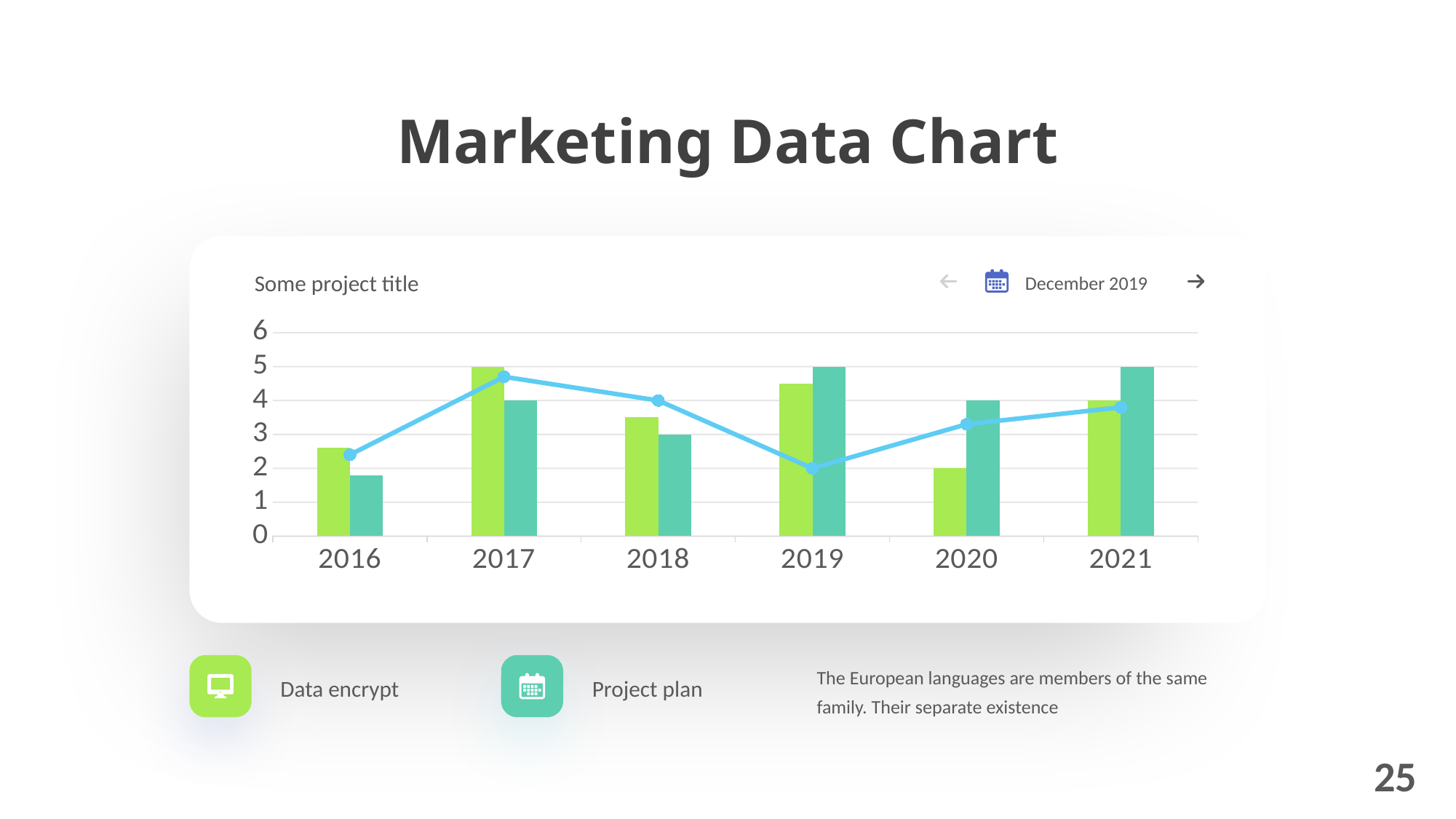
What is the difference between the teal bar for 2021 and the teal bar for 2020? 1 In which year is the light green bar the lowest? 2020 What is the value of the light green bar for 2017? 5 What is the value of the teal bar for 2018? 3 What is the title shown above the chart inside the card? Some project title Which is larger in 2019, the light green bar or the teal bar? the teal bar What is the value of the blue line point for 2019? 2 What is the value of the light green bar for 2020? 2 What is the value of the blue line point for 2018? 4 How many years are shown on the x axis of the chart? 6 In which year is the teal bar the lowest? 2016 Is the value of the light green bar for 2016 greater or less than 3? less